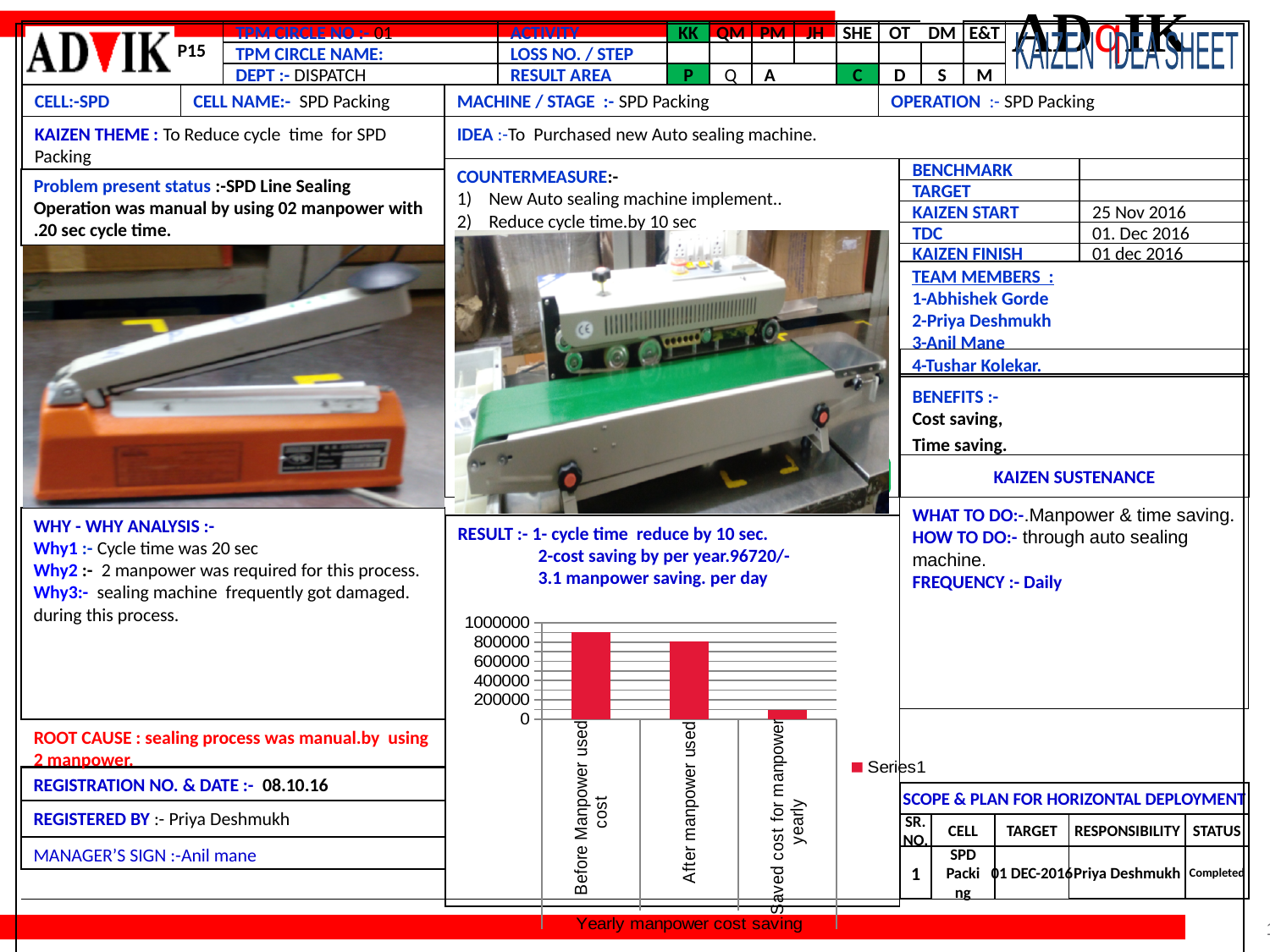
Which category has the highest bar in the chart? Before Manpower used cost Do the bar values rise or fall from left to right across the categories? fall Which is larger, the bar for Before Manpower used cost or the bar for Saved cost for manpower yearly? Before Manpower used cost How many categories are plotted in the bar chart? 3 What kind of chart is shown on the slide? bar chart What is the legend entry shown for the chart? Series1 Is the value for After manpower used greater or less than 600000? greater Is the value for Before Manpower used cost greater or less than 800000? greater How many series does the chart legend list? 1 Is the value for Saved cost for manpower yearly greater or less than 200000? less Which category has the lowest bar in the chart? Saved cost for manpower yearly